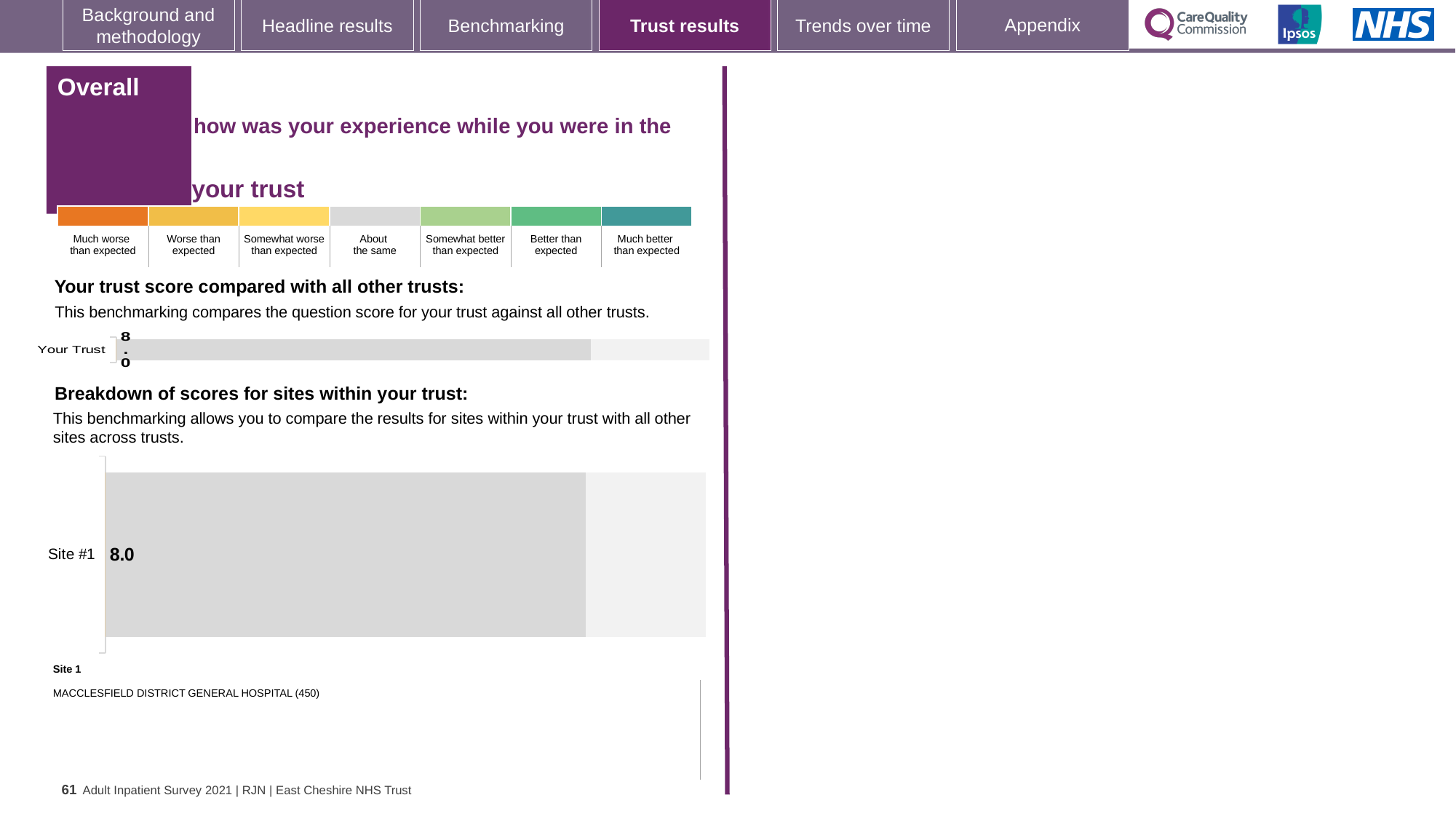
In the 'Your trust score compared with all other trusts' chart, what is the score for Your Trust? 8.0 What kind of chart is the 'Your trust score compared with all other trusts' chart? bar chart How many categories are plotted in the 'Your trust score compared with all other trusts' chart? 1 How many rating categories does the colour scale above the charts show, from 'Much worse than expected' to 'Much better than expected'? 7 How many sites are plotted in the 'Breakdown of scores for sites within your trust' chart? 1 In the 'Breakdown of scores for sites within your trust' chart, what is the score for Site #1? 8.0 Is the score for Your Trust in the 'Your trust score compared with all other trusts' chart greater or less than 10? less What kind of chart is the 'Breakdown of scores for sites within your trust' chart? bar chart What is the label of the only bar in the 'Your trust score compared with all other trusts' chart? Your Trust Is the score for Site #1 in the 'Breakdown of scores for sites within your trust' chart greater or less than 5? greater